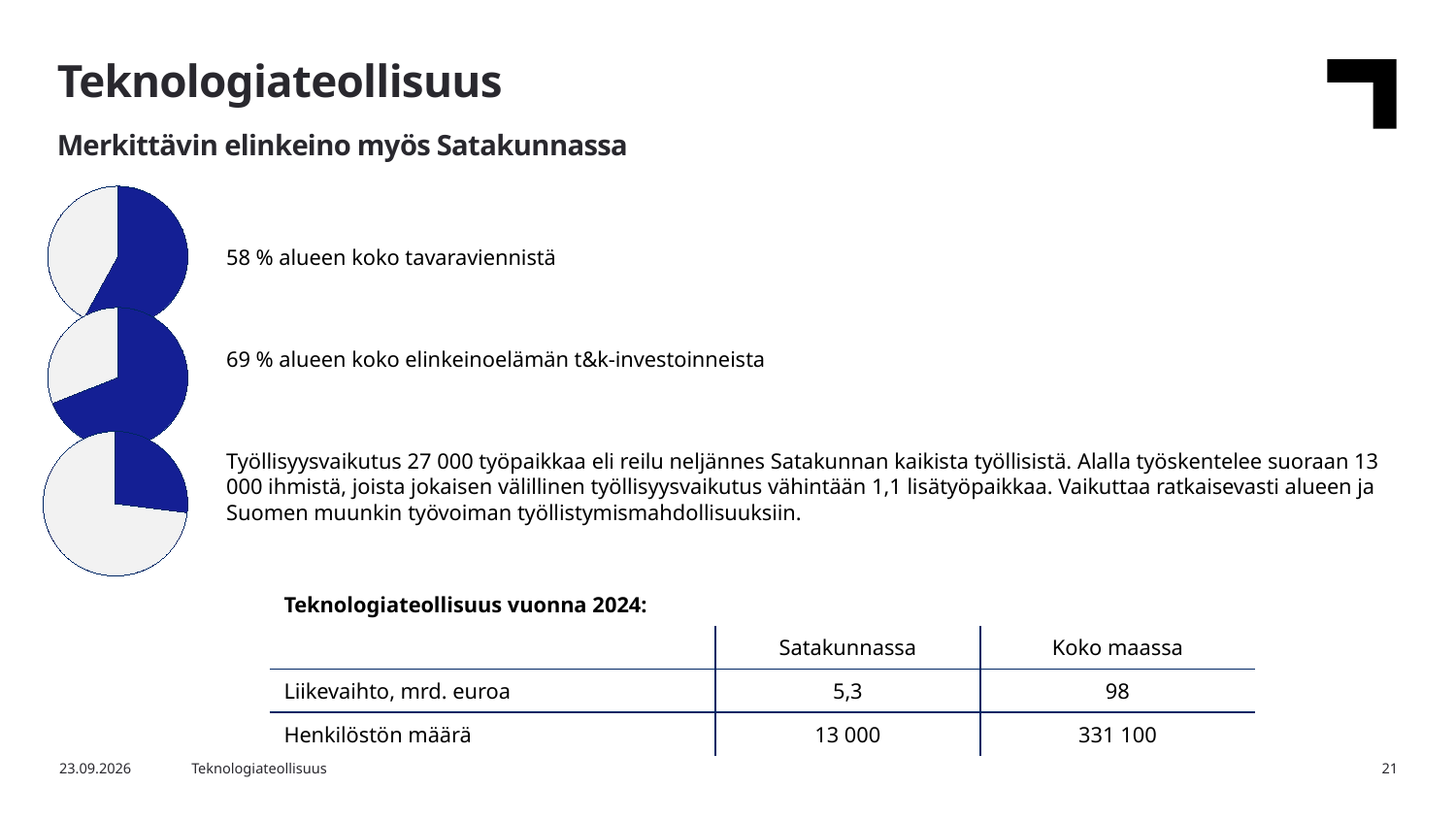
In the top pie chart, what share of the region's total goods exports does the blue slice represent? 58 % Which pie chart has the largest blue slice: the top, middle or bottom one? Middle How many slices does each pie chart have? 2 What is the main title of the slide containing the pie charts? Teknologiateollisuus Is the blue slice larger in the top pie chart (goods exports) or in the middle pie chart (R&D investments)? Middle pie chart (R&D investments) What is the difference between the share shown for R&D investments (middle pie) and the share shown for goods exports (top pie)? 11 % What kind of chart is used on the left side of the slide? Pie chart How many pie charts are shown on the slide? 3 In the bottom pie chart, does the blue slice cover more or less than half of the pie? less In the middle pie chart, what share of the region's business R&D investments does the blue slice represent? 69 % What colour is the highlighted slice in each pie chart? Blue Which pie chart has the smallest blue slice: the top, middle or bottom one? Bottom